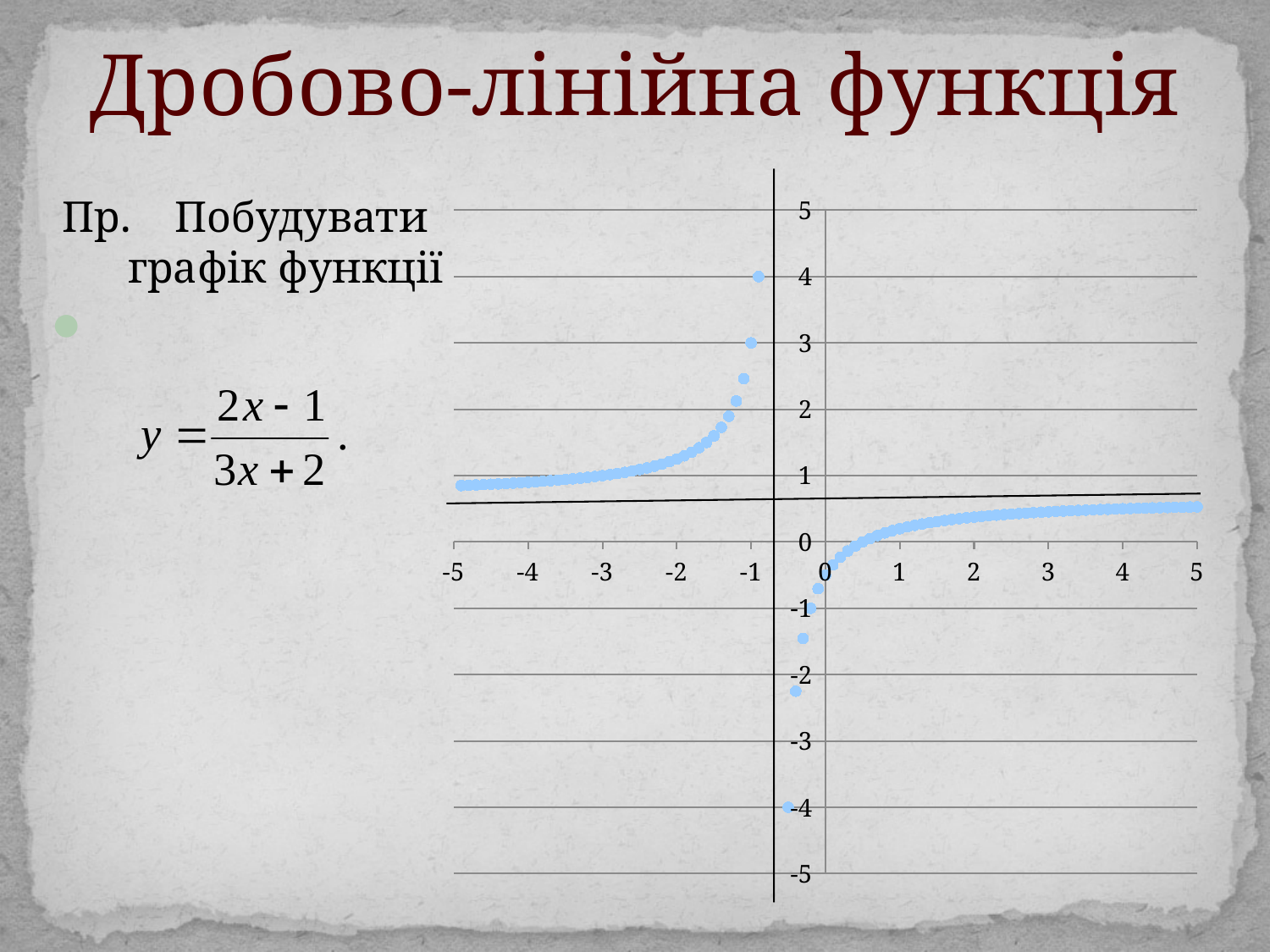
Do the plotted values rise or fall as x increases from -5 to -1? rise Is the plotted value at x = -5 greater or less than 0? greater What is the lowest y value reached by a plotted point on the chart? -4 What function is plotted on the chart, according to the slide? y = (2x - 1)/(3x + 2) Do the plotted values rise or fall as x increases from 1 to 5? rise What is the highest y value reached by a plotted point on the chart? 4 What is the range of the x axis on the chart? -5 to 5 Is the plotted value at x = -2 greater or less than 1? greater What kind of chart is shown on the slide? scatter chart Is the plotted value at x = 1 greater or less than 0? greater Which has the larger plotted value, x = -2 or x = 2? x = -2